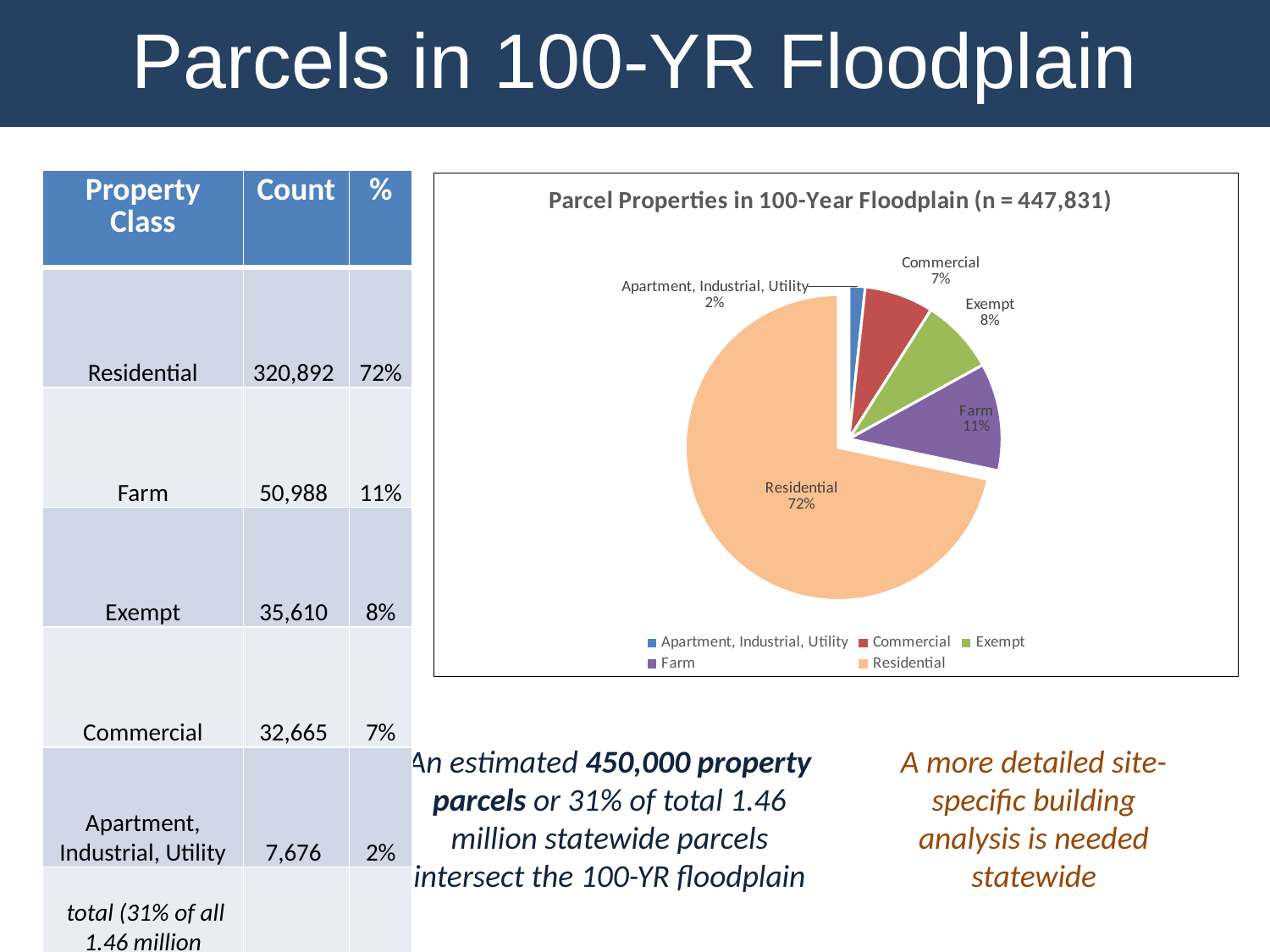
What is the difference in percentage points between the Residential and Farm slices? 61 How many slices does the pie chart have? 5 What share of the pie does Farm represent? 11% What share of the pie does Exempt represent? 8% What is the value of n given in the chart title? 447,831 What share of the pie does Residential represent? 72% Which slice is larger, Farm or Exempt? Farm What kind of chart is shown on the slide? pie chart Which category has the largest slice of the pie? Residential Which category has the smallest slice of the pie? Apartment, Industrial, Utility